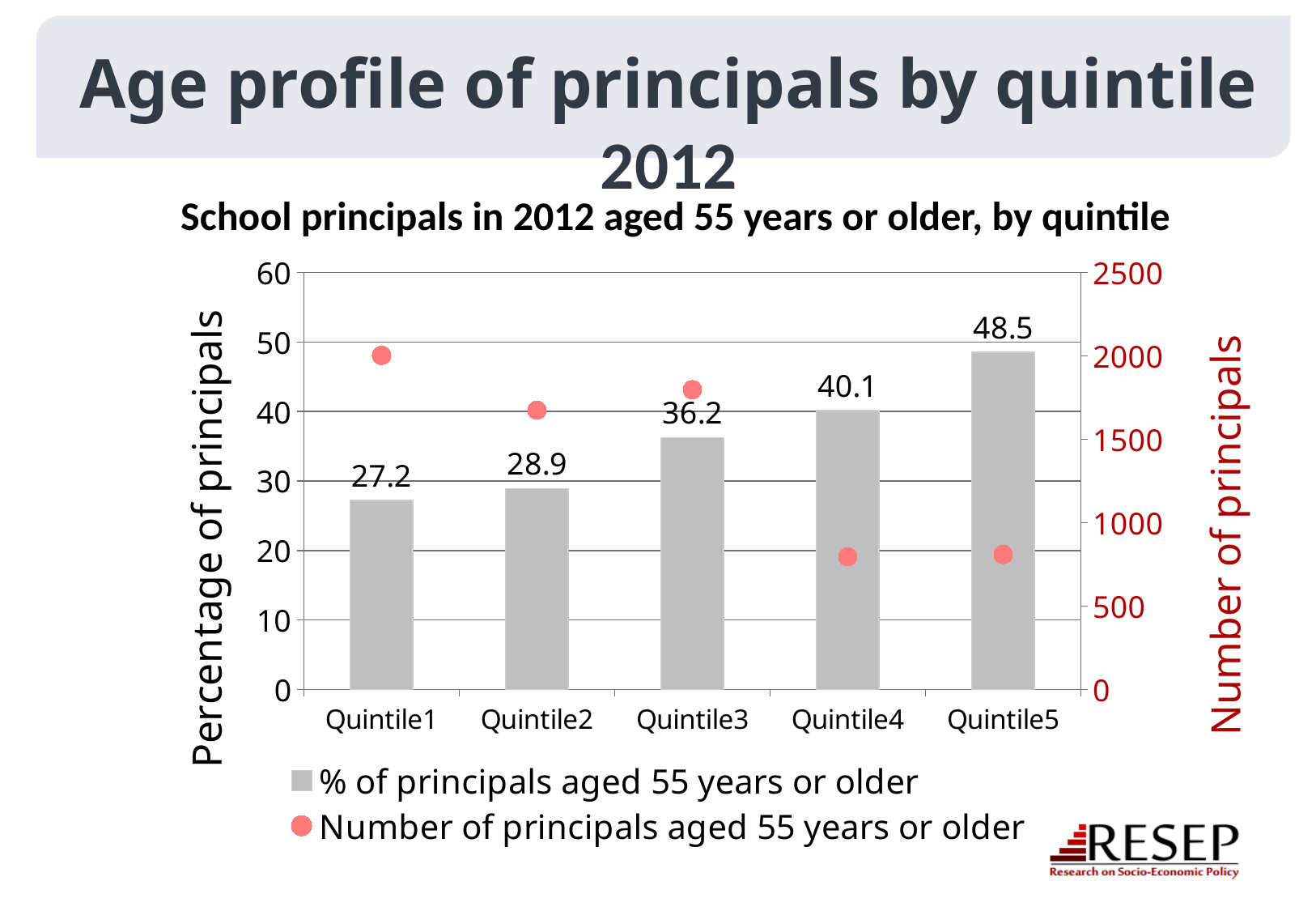
Is the number of principals aged 55 years or older in Quintile4 greater or less than 1000? less Which quintile has the lowest percentage of principals aged 55 years or older? Quintile1 Does the percentage of principals aged 55 years or older rise or fall from Quintile1 to Quintile5? rise What is the label of the right-hand vertical axis? Number of principals How many series does the legend list? 2 What is the percentage of principals aged 55 years or older in Quintile3? 36.2 Which has a higher percentage of principals aged 55 years or older, Quintile2 or Quintile4? Quintile4 What is the percentage of principals aged 55 years or older in Quintile5? 48.5 How many quintiles are shown on the x axis? 5 Is the number of principals aged 55 years or older in Quintile1 greater or less than 1500? greater What is the difference in the percentage of principals aged 55 years or older between Quintile5 and Quintile1? 21.3 Which quintile has the highest percentage of principals aged 55 years or older? Quintile5